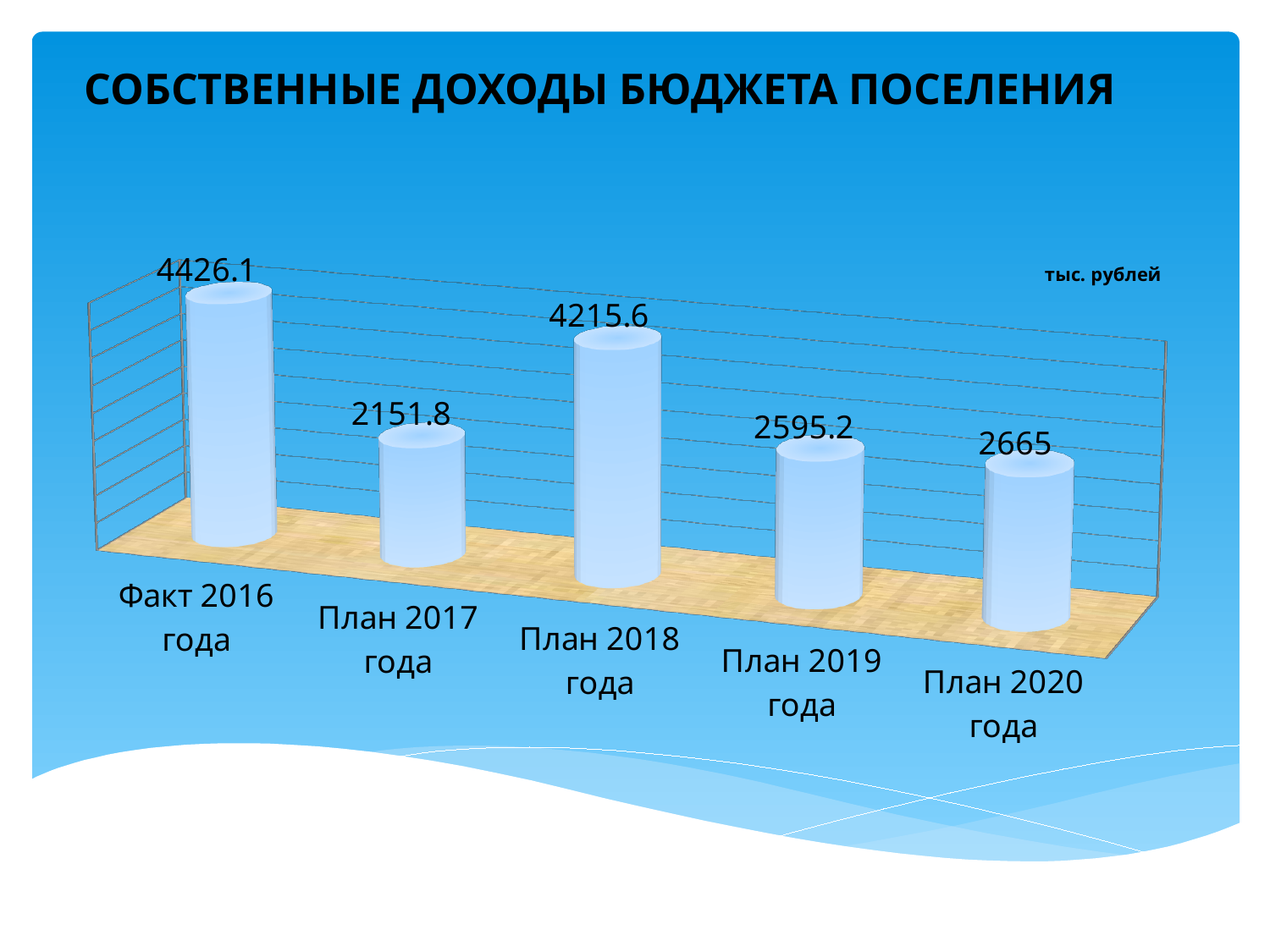
Which category has the highest value? Факт 2016 года How many categories are shown in the chart? 5 What is the difference between the values for План 2020 года and План 2019 года? 69.8 What is the title of the chart? СОБСТВЕННЫЕ ДОХОДЫ БЮДЖЕТА ПОСЕЛЕНИЯ In what units are the values on the chart expressed? тыс. рублей Which is larger, the value for План 2018 года or the value for План 2019 года? План 2018 года What is the value for Факт 2016 года? 4426.1 What is the difference between the values for Факт 2016 года and План 2017 года? 2274.3 What kind of chart is shown on the slide? Bar chart What is the value for План 2018 года? 4215.6 Which category has the lowest value? План 2017 года What is the value for План 2020 года? 2665